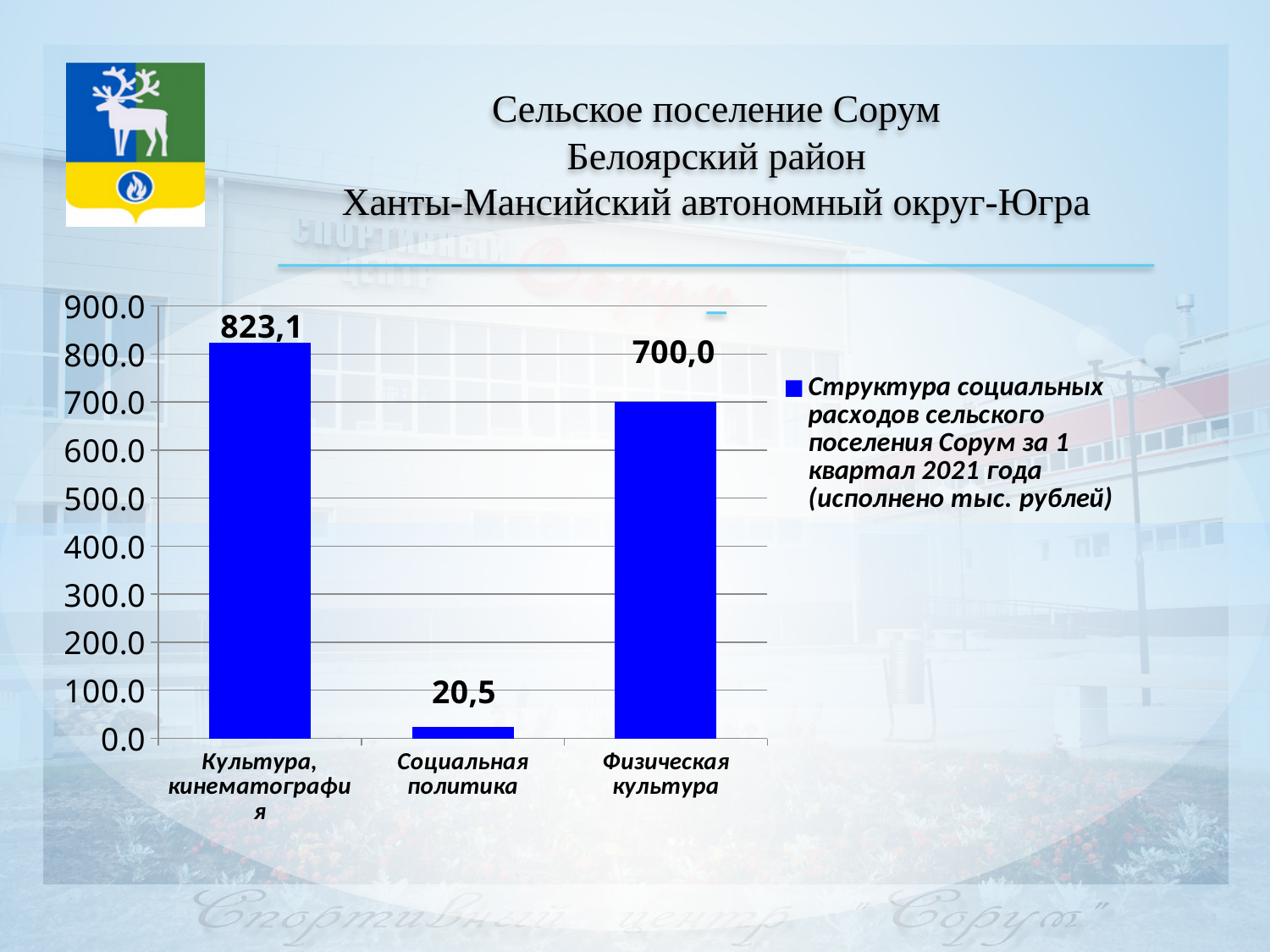
How many series does the legend list? 1 What is the value for Социальная политика? 20,5 Which category has the lowest value? Социальная политика What is the difference between the values for Культура, кинематография and Физическая культура? 123,1 Is the value for Культура, кинематография greater or less than 800.0? greater Which is larger, the value for Физическая культура or the value for Социальная политика? Физическая культура What kind of chart is shown on the slide? bar chart What is the difference between the values for Физическая культура and Социальная политика? 679,5 How many categories are shown on the chart? 3 Which category has the highest value? Культура, кинематография What is the value for Физическая культура? 700,0 What is the value for Культура, кинематография? 823,1